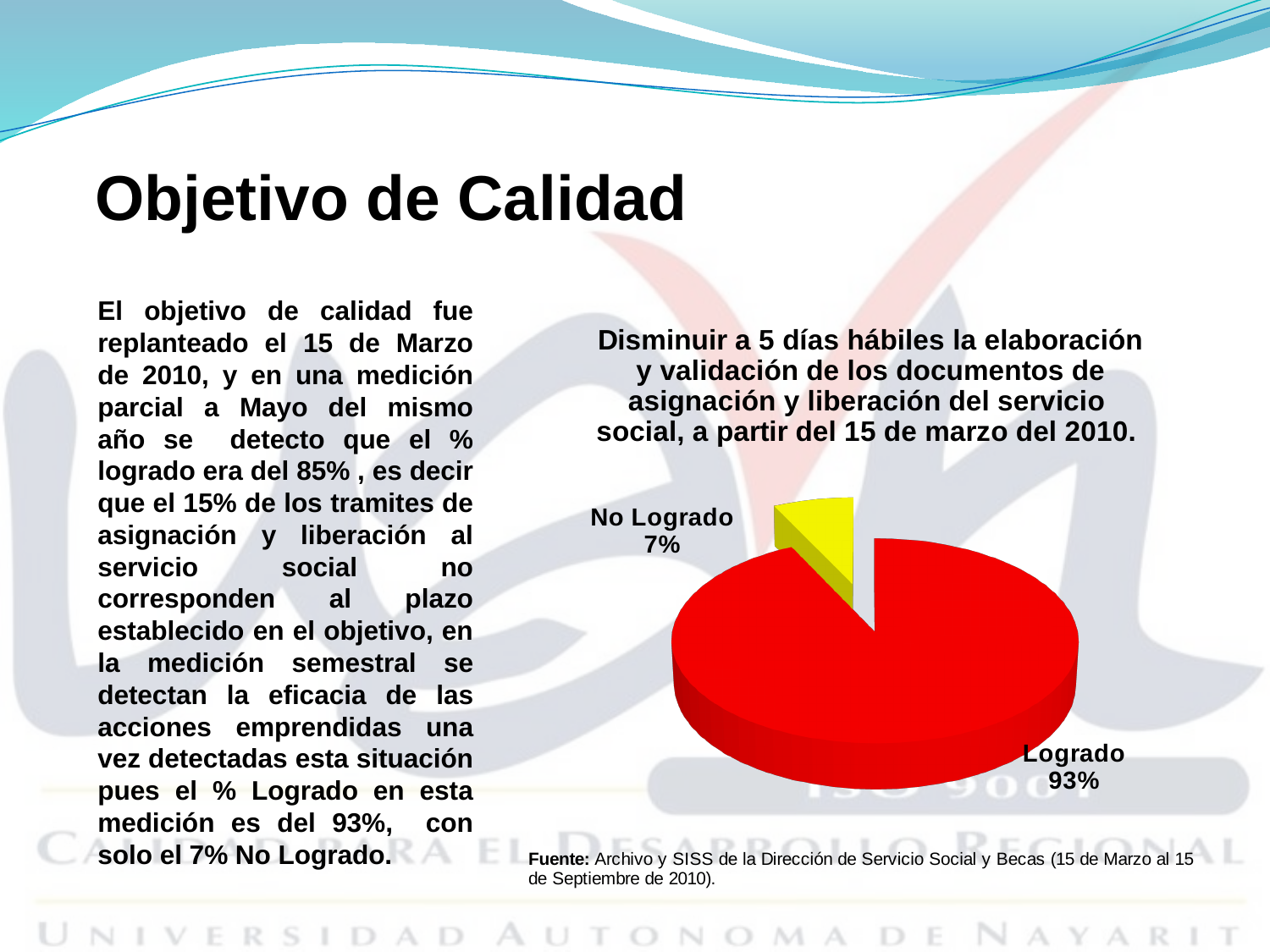
Which slice of the pie chart is the largest? Logrado What kind of chart is shown on the slide? pie chart What share of the pie does the Logrado slice represent? 93% How many slices does the pie chart have? 2 Which is larger, Logrado or No Logrado? Logrado What is the difference between the Logrado and No Logrado percentages? 86% Which slice of the pie chart is the smallest? No Logrado What is the value for Logrado in the pie chart? 93% What is the value for No Logrado in the pie chart? 7% What colour is the Logrado slice? red What colour is the No Logrado slice? yellow